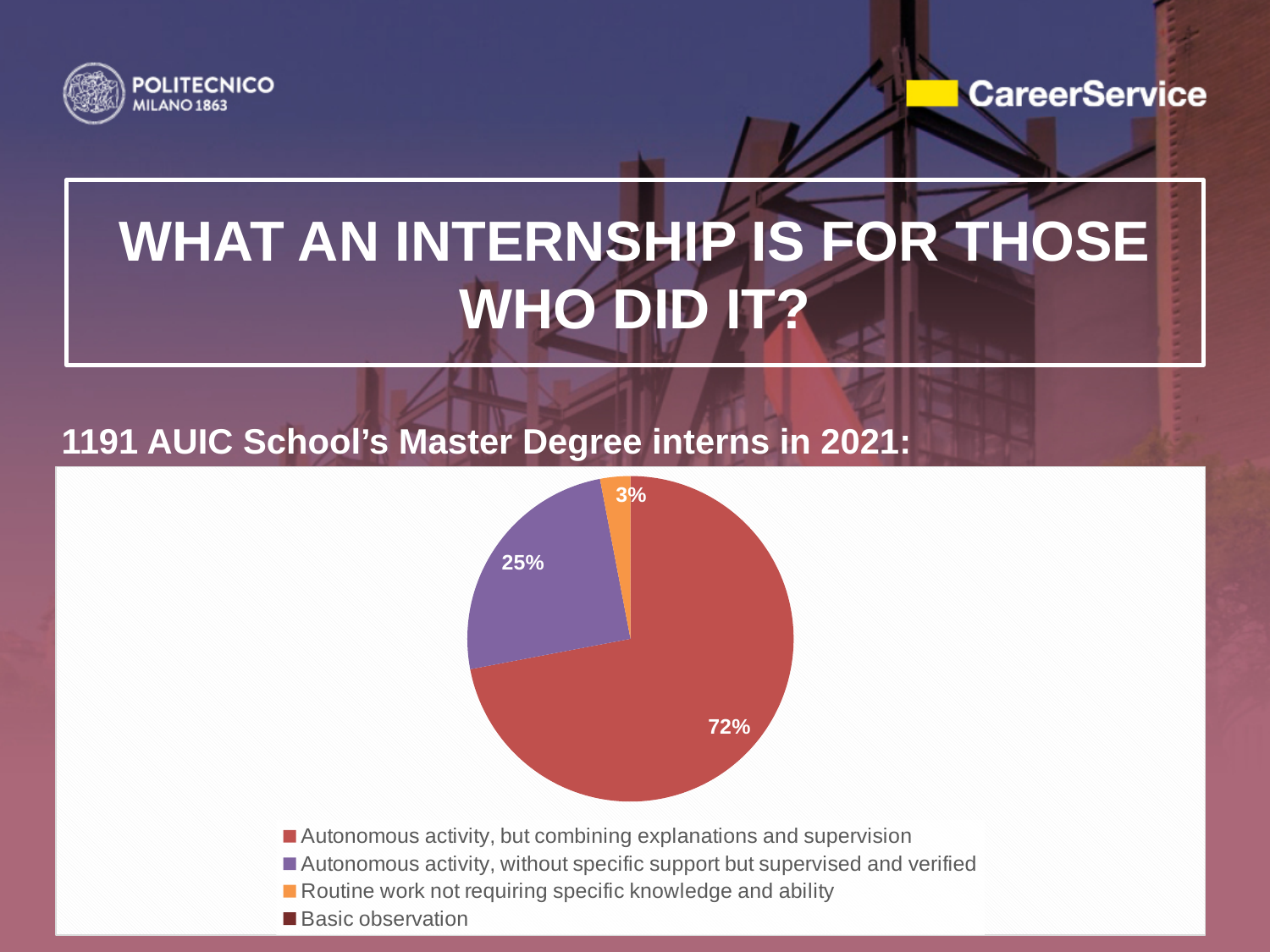
What colour is the slice for "Autonomous activity, without specific support but supervised and verified"? purple Which is larger: the share for "Autonomous activity, without specific support but supervised and verified" or the share for "Routine work not requiring specific knowledge and ability"? Autonomous activity, without specific support but supervised and verified According to the text above the chart, how many AUIC School's Master Degree interns in 2021 does the chart cover? 1191 Which labelled slice of the pie is the smallest? Routine work not requiring specific knowledge and ability What is the difference in percentage points between the 72% slice and the 25% slice? 47 How many slices of the pie have a percentage label printed on them? 3 What share of the pie is labelled for "Autonomous activity, without specific support but supervised and verified"? 25% How many entries does the legend of the pie chart list? 4 What kind of chart is shown on the slide? pie chart What share of the pie is labelled for "Routine work not requiring specific knowledge and ability"? 3% What share of the pie is labelled for "Autonomous activity, but combining explanations and supervision"? 72% Which category has the largest slice of the pie? Autonomous activity, but combining explanations and supervision